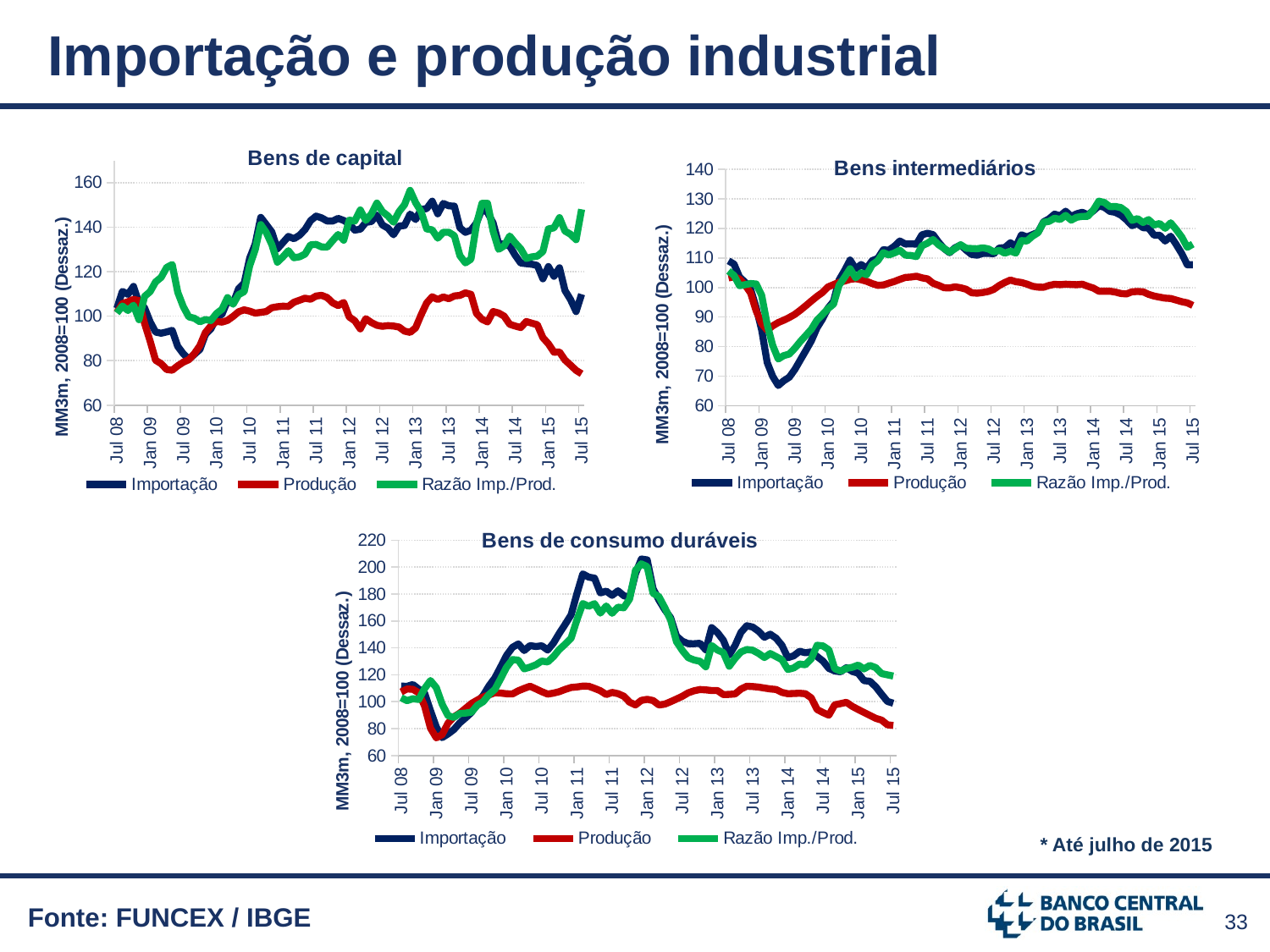
What type of chart is the 'Bens de capital' chart? line chart How many series does the legend of the 'Bens intermediários' chart list? 3 In the 'Bens de consumo duráveis' chart, is the peak value of Importação (around Jan 12) greater or less than 200? greater How many charts are shown on the slide? 3 What is the title of the chart at the bottom of the slide? Bens de consumo duráveis In the 'Bens de capital' chart, is the value of Produção at Jul 15 greater or less than 80? less In the 'Bens intermediários' chart, does the Importação series rise or fall between Jan 14 and Jul 15? fall In the 'Bens intermediários' chart, is the value of Produção at Jul 15 greater or less than 100? less In the 'Bens de capital' chart, which series is higher at Jul 15: Razão Imp./Prod. or Produção? Razão Imp./Prod.